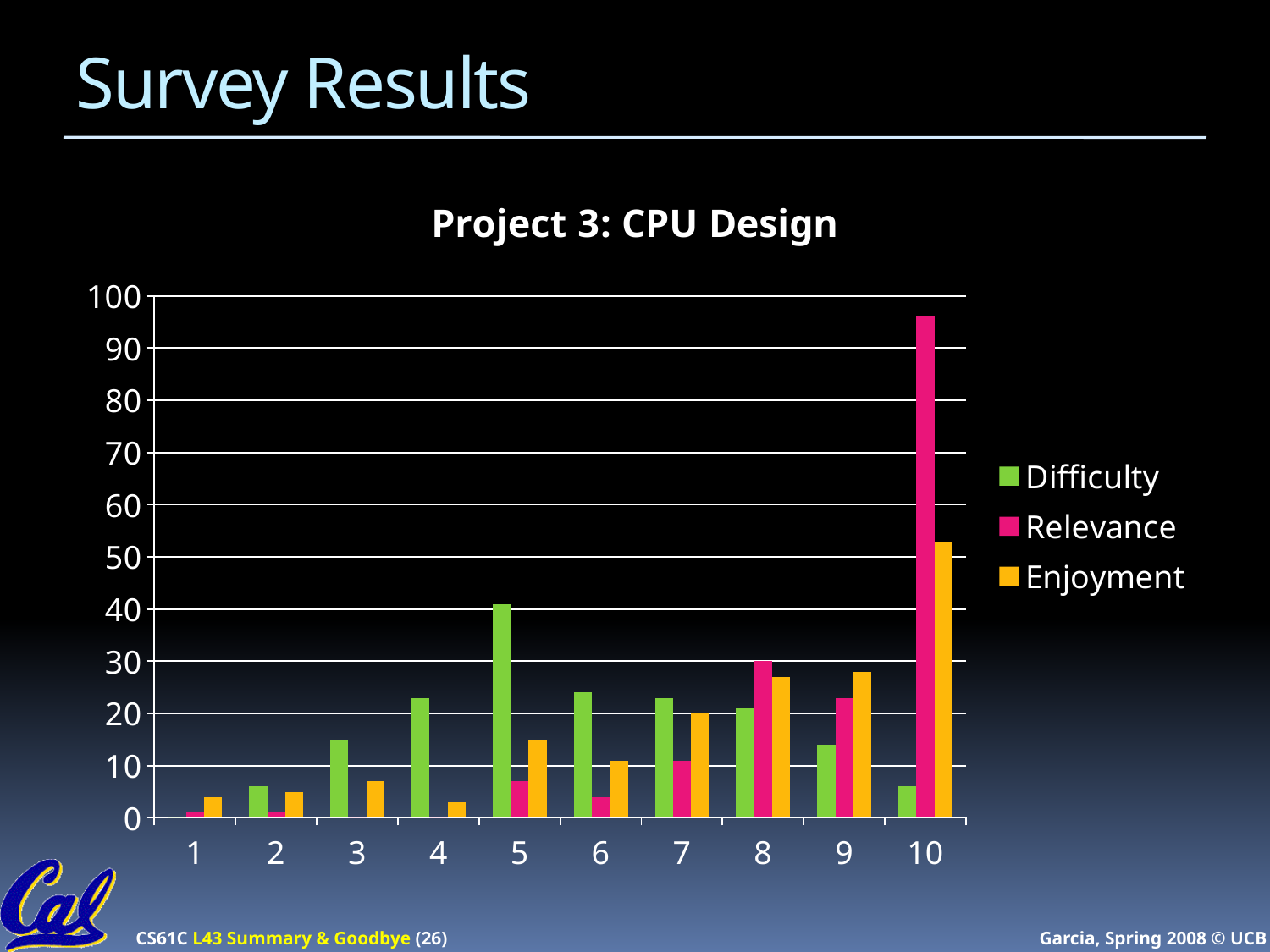
For which category is the Enjoyment value highest? 10 For which category is the Relevance value highest? 10 Do the Difficulty values rise or fall from category 1 to category 5? rise For which category is the Difficulty value highest? 5 For category 8, which is larger: Relevance or Difficulty? Relevance Which series are listed in the legend? Difficulty, Relevance, Enjoyment Is the Difficulty value for category 5 greater or less than 30? greater How many series does the legend list? 3 How many categories are shown on the x axis? 10 Is the Relevance value for category 10 greater or less than 90? greater What kind of chart is shown on the slide? bar chart What is the title of the chart? Project 3: CPU Design